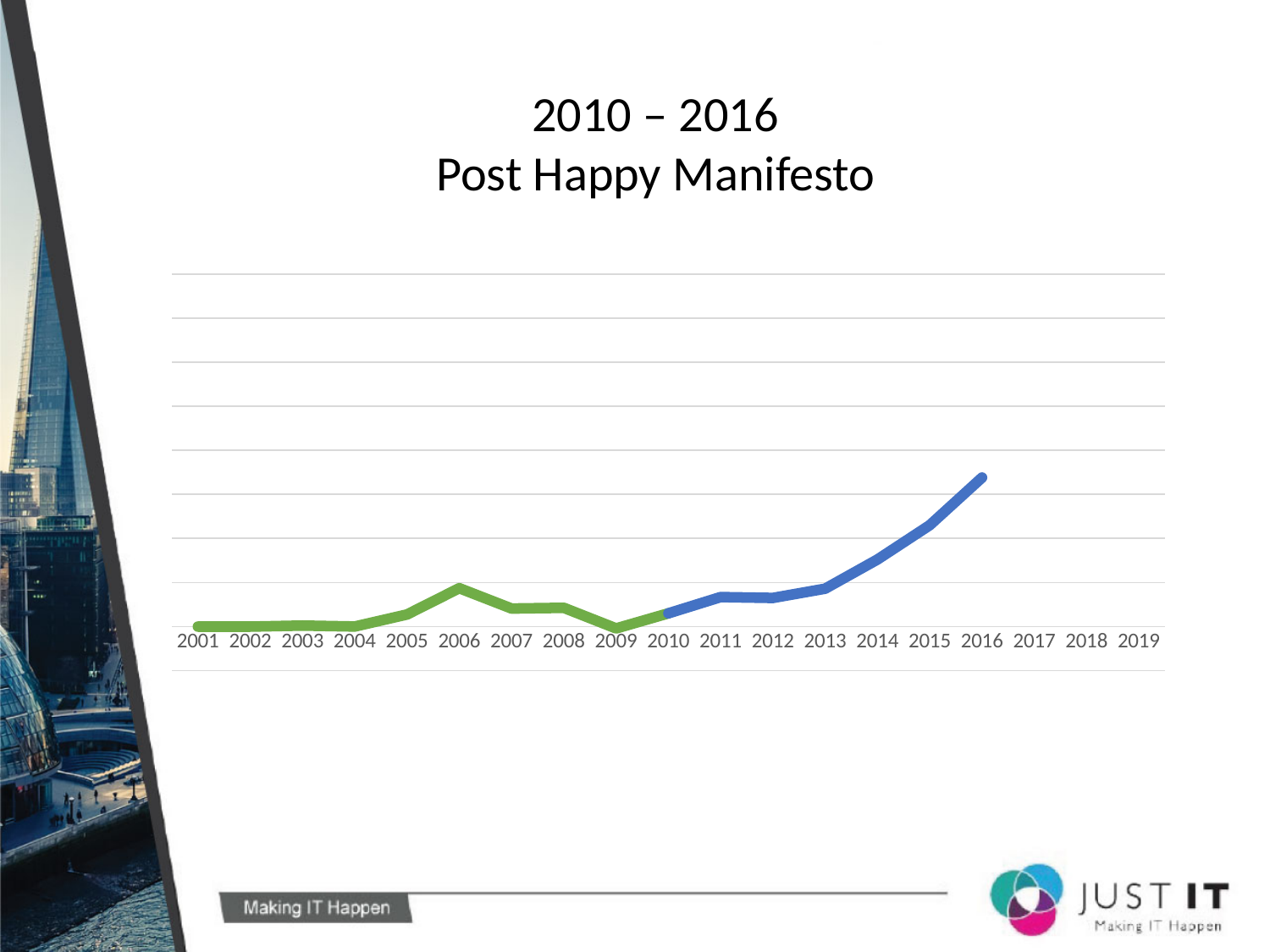
Which year has the larger value, 2005 or 2006? 2006 Which year has the larger value, 2013 or 2015? 2015 How many years are labelled on the x axis of the chart? 19 What kind of chart is shown on the slide? line chart What is the last year for which the line shows data? 2016 Which year has the larger value, 2006 or 2016? 2016 What colour is the line segment covering 2010 to 2016? blue Does the line rise or fall between 2006 and 2007? falls Which year has the highest value on the chart? 2016 Does the line rise or fall between 2010 and 2016? rises What is the first year labelled on the x axis? 2001